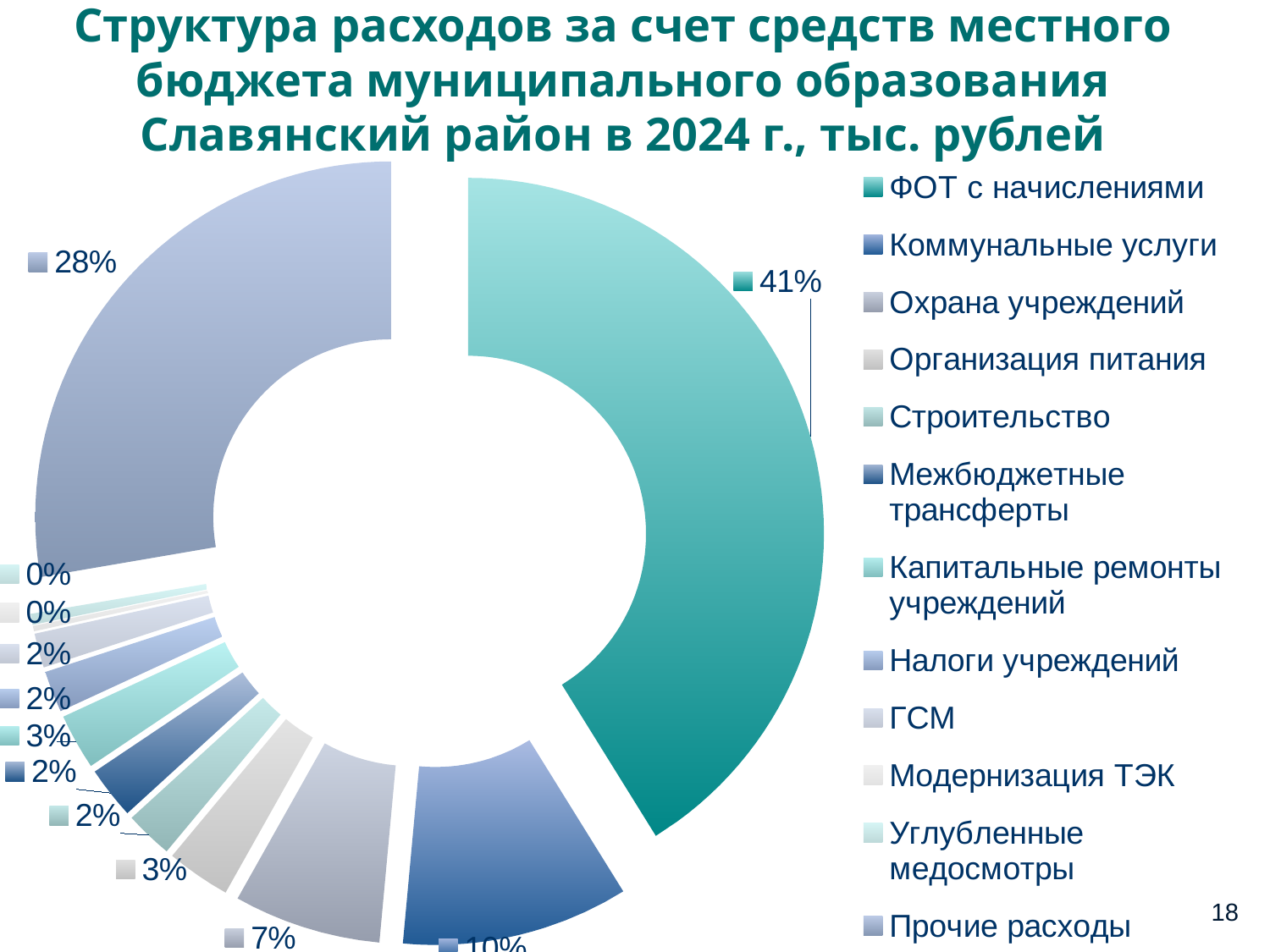
In what units are the expenditures expressed according to the chart title? тыс. рублей What share of expenditures does ФОТ с начислениями account for? 41% What percentage is shown for Охрана учреждений? 7% What is the smallest percentage value labelled on the chart? 0% What is the combined share of ФОТ с начислениями and Прочие расходы? 69% Which is larger: the share for ФОТ с начислениями or the share for Прочие расходы? ФОТ с начислениями By how many percentage points does the share of ФОТ с начислениями exceed the share of Прочие расходы? 13 percentage points How many categories are listed in the chart legend? 12 What type of chart is shown on the slide? Doughnut (pie) chart Which category has the largest share of expenditures? ФОТ с начислениями What share of expenditures is labelled for Прочие расходы? 28% For which year does the chart show the structure of expenditures? 2024